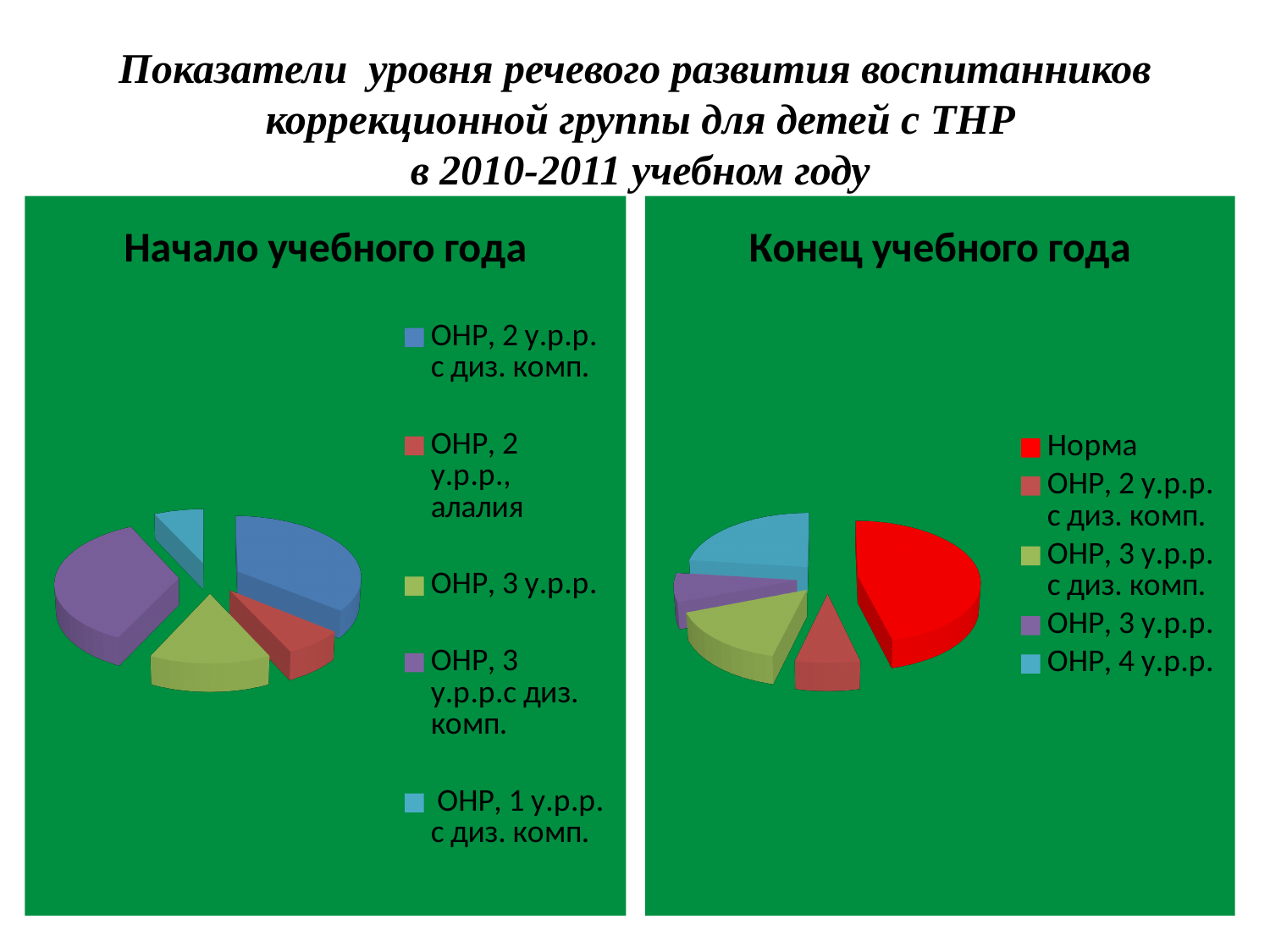
In the chart "Конец учебного года", which is larger: the slice for "Норма" or the slice for "ОНР, 2 у.р.р. с диз. комп."? Норма In the chart "Начало учебного года", how many entries does the legend list? 5 In the chart "Конец учебного года", how many slices does the pie have? 5 What kind of chart is the left chart titled "Начало учебного года"? pie chart In the chart "Конец учебного года", how many entries does the legend list? 5 What kind of chart is the right chart titled "Конец учебного года"? pie chart What is the title of the chart on the left side of the slide? Начало учебного года In the chart "Начало учебного года", which is larger: the slice for "ОНР, 2 у.р.р. с диз. комп." or the slice for "ОНР, 1 у.р.р. с диз. комп."? ОНР, 2 у.р.р. с диз. комп. In the chart "Конец учебного года", which category has the largest slice? Норма In the chart "Конец учебного года", what colour is the slice for "Норма"? red In the chart "Конец учебного года", which is larger: the slice for "ОНР, 3 у.р.р. с диз. комп." or the slice for "ОНР, 3 у.р.р."? ОНР, 3 у.р.р. с диз. комп. In the chart "Начало учебного года", how many slices does the pie have? 5